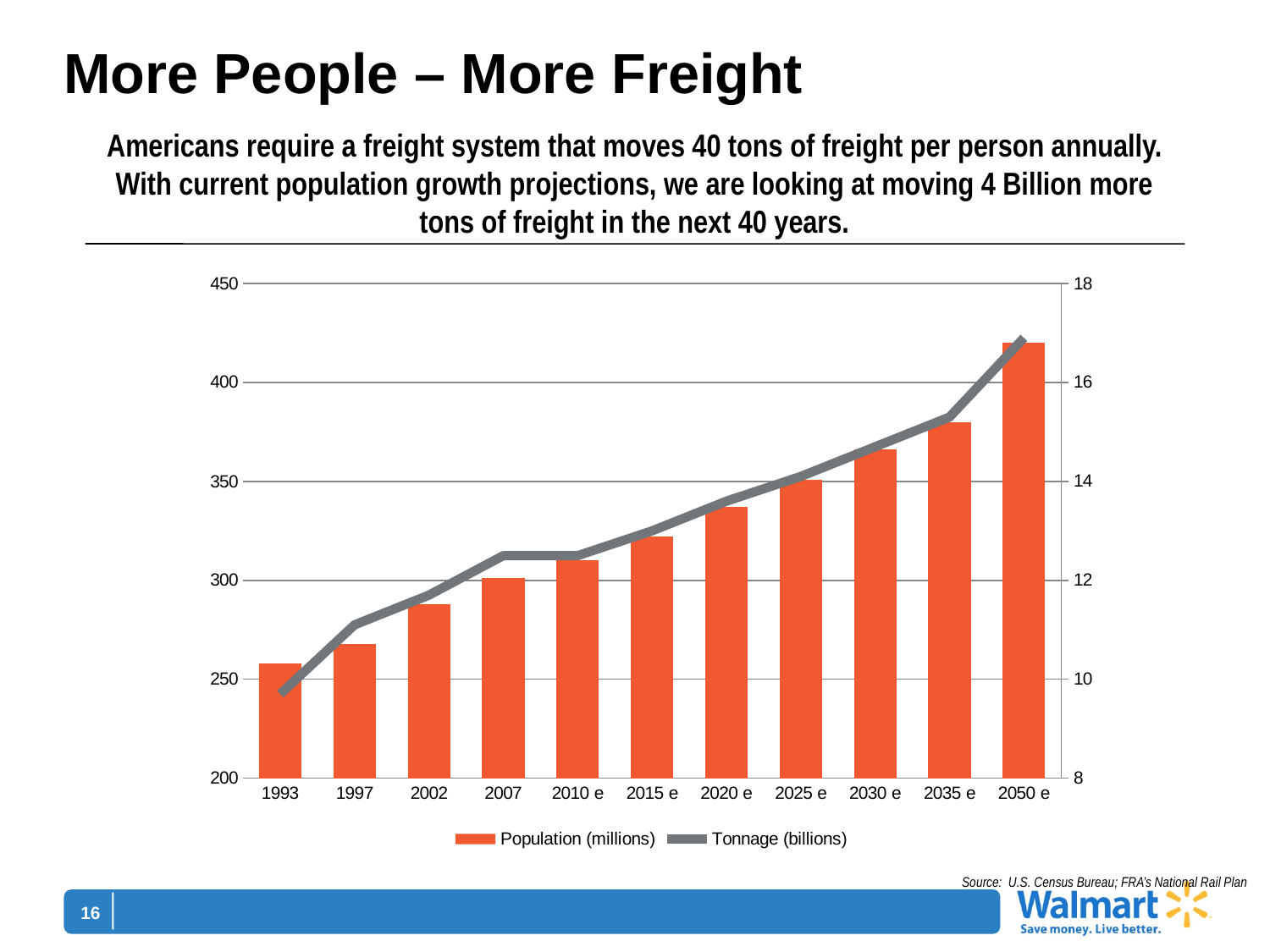
How many categories are shown on the x axis of the chart? 11 What kind of chart is shown on the slide? Combined bar and line chart Which series is drawn as a grey line in the chart? Tonnage (billions) Which year has the highest Population (millions) bar? 2050 e How many series does the chart's legend list? 2 Is the Population (millions) value for 2020 e greater or less than 350? less Do the Tonnage (billions) values rise or fall from 1993 to 2050 e? rise Is the Population (millions) value for 2050 e greater or less than 400? greater Is the Population (millions) value for 1993 greater or less than 300? less Which year has the lowest Population (millions) bar? 1993